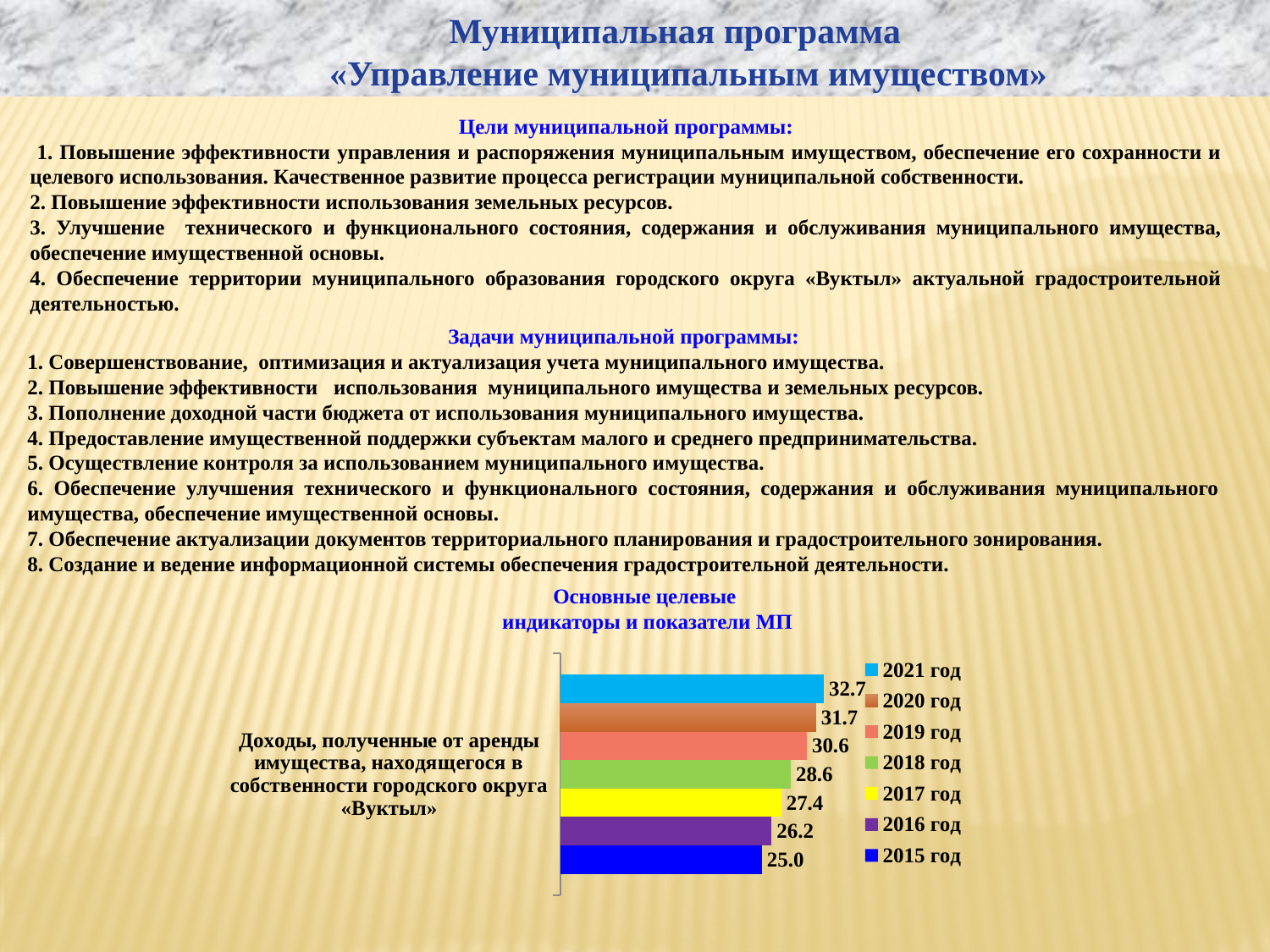
Какое значение показано для 2015 года на диаграмме? 25.0 Какого типа диаграмма показана на слайде? Столбчатая (линейчатая) диаграмма Какое значение показано для 2021 года на диаграмме «Доходы, полученные от аренды имущества»? 32.7 Что больше: значение 2020 года или значение 2018 года? 2020 год На сколько значение 2019 года больше значения 2016 года? 4.4 На сколько значение 2021 года больше значения 2015 года? 7.7 Какое значение показано для 2018 года на диаграмме? 28.6 Какое значение показано для 2017 года на диаграмме? 27.4 Какой год имеет наибольшее значение на диаграмме? 2021 год Какой год имеет наименьшее значение на диаграмме? 2015 год Сколько лет (серий) перечислено в легенде диаграммы? 7 Как изменяются значения от 2015 года к 2021 году: растут или падают? Растут